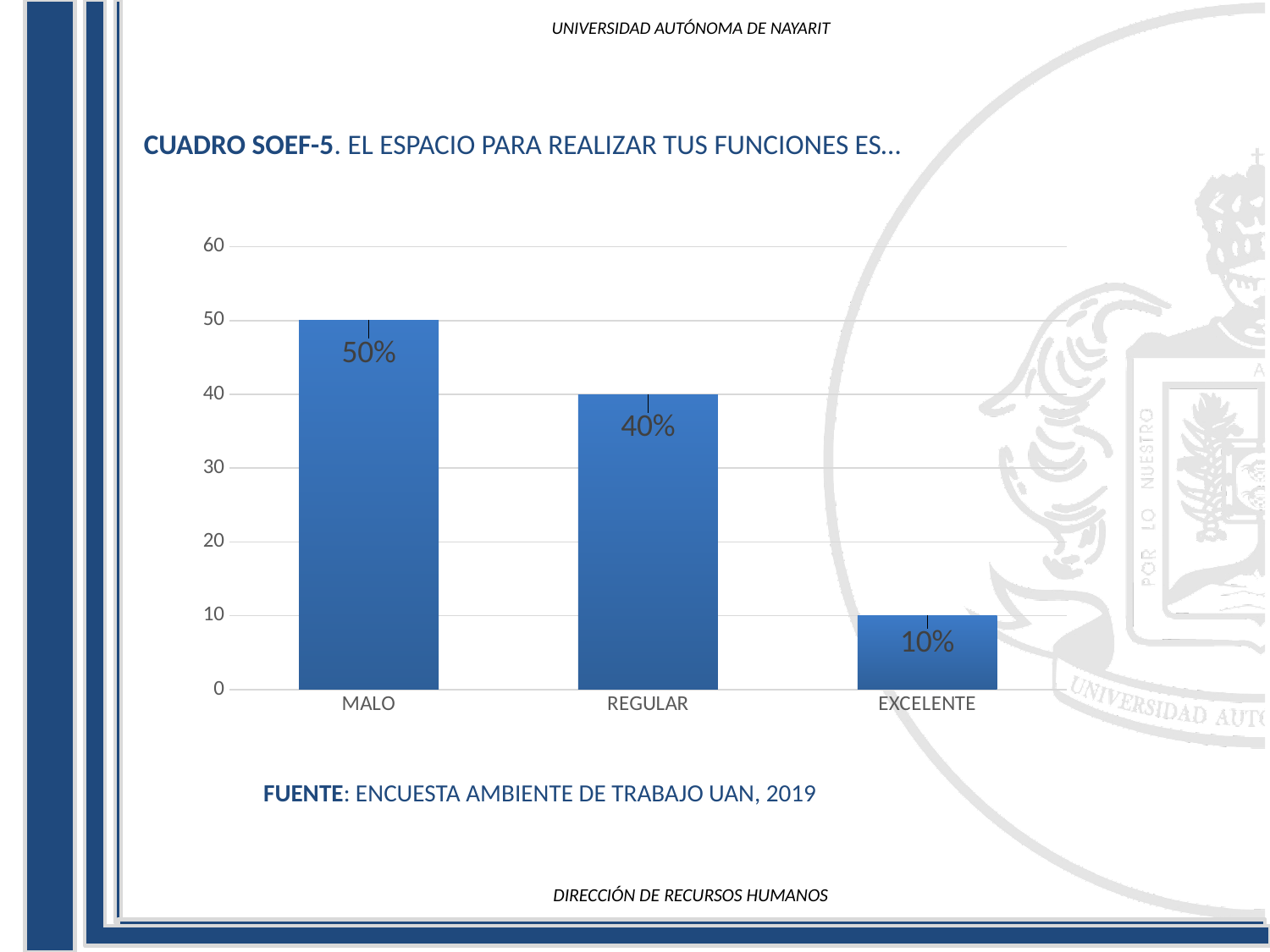
What is the difference between the values for REGULAR and EXCELENTE? 30% What kind of chart is shown on the slide? bar chart How many categories are shown on the x axis? 3 What is the value for REGULAR? 40% Do the values rise or fall from MALO to EXCELENTE along the x axis? fall Which category has the lowest value? EXCELENTE Is the value for REGULAR greater or less than 30? greater Which category has the highest value? MALO What is the value for MALO? 50% What is the difference between the values for MALO and REGULAR? 10% What is the value for EXCELENTE? 10% Which is larger, the value for REGULAR or the value for EXCELENTE? REGULAR